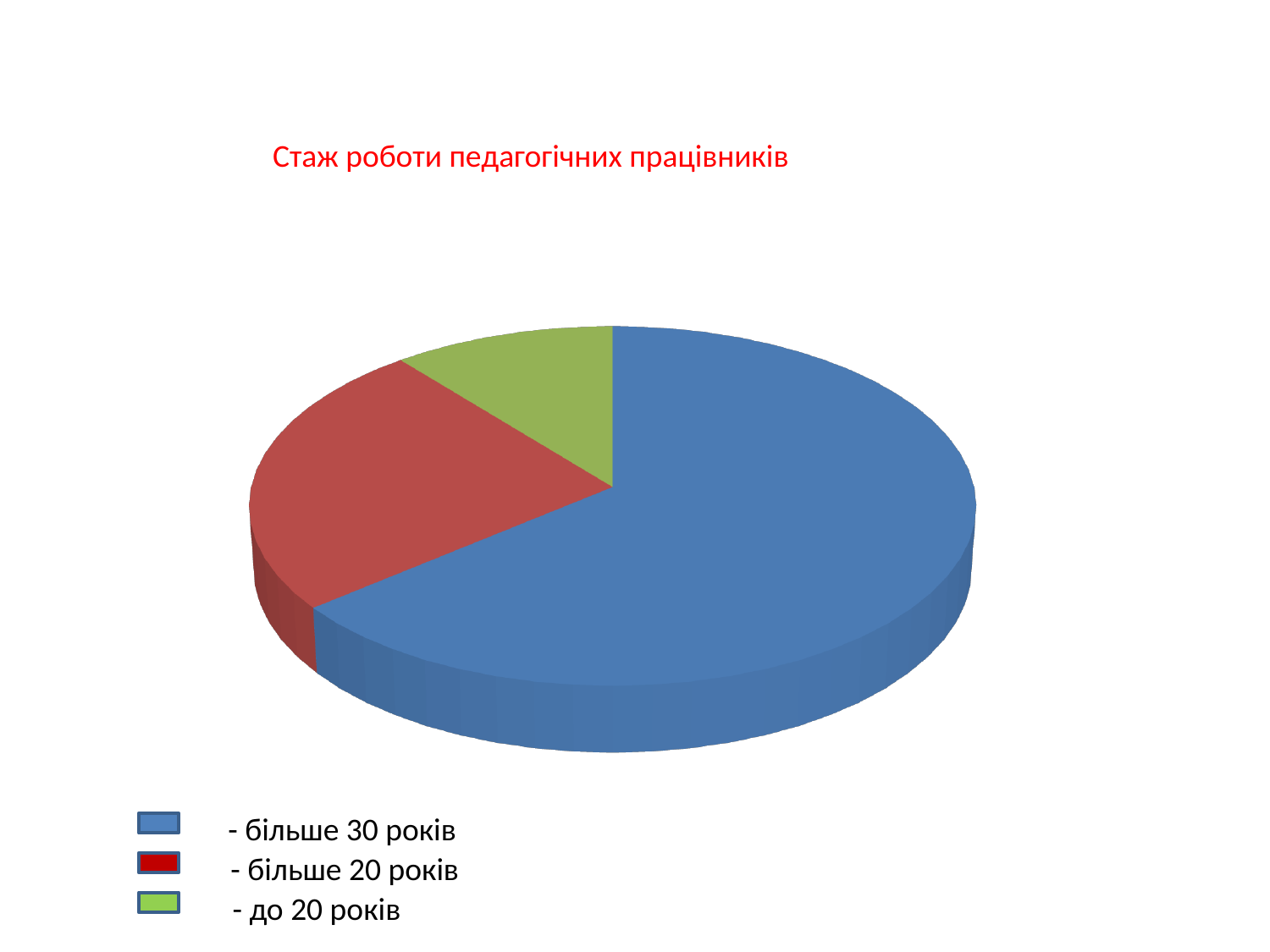
Does the slice for більше 30 років take up more or less than half of the pie? more How many slices does the pie chart have? 3 Which slice is larger: більше 30 років or більше 20 років? більше 30 років Which slice is larger: більше 20 років or до 20 років? більше 20 років Which category has the largest slice of the pie? більше 30 років How many entries does the legend list? 3 What colour is the slice for до 20 років? green What is the title of the chart? Стаж роботи педагогічних працівників Which category has the smallest slice of the pie? до 20 років What kind of chart is shown on the slide? pie chart